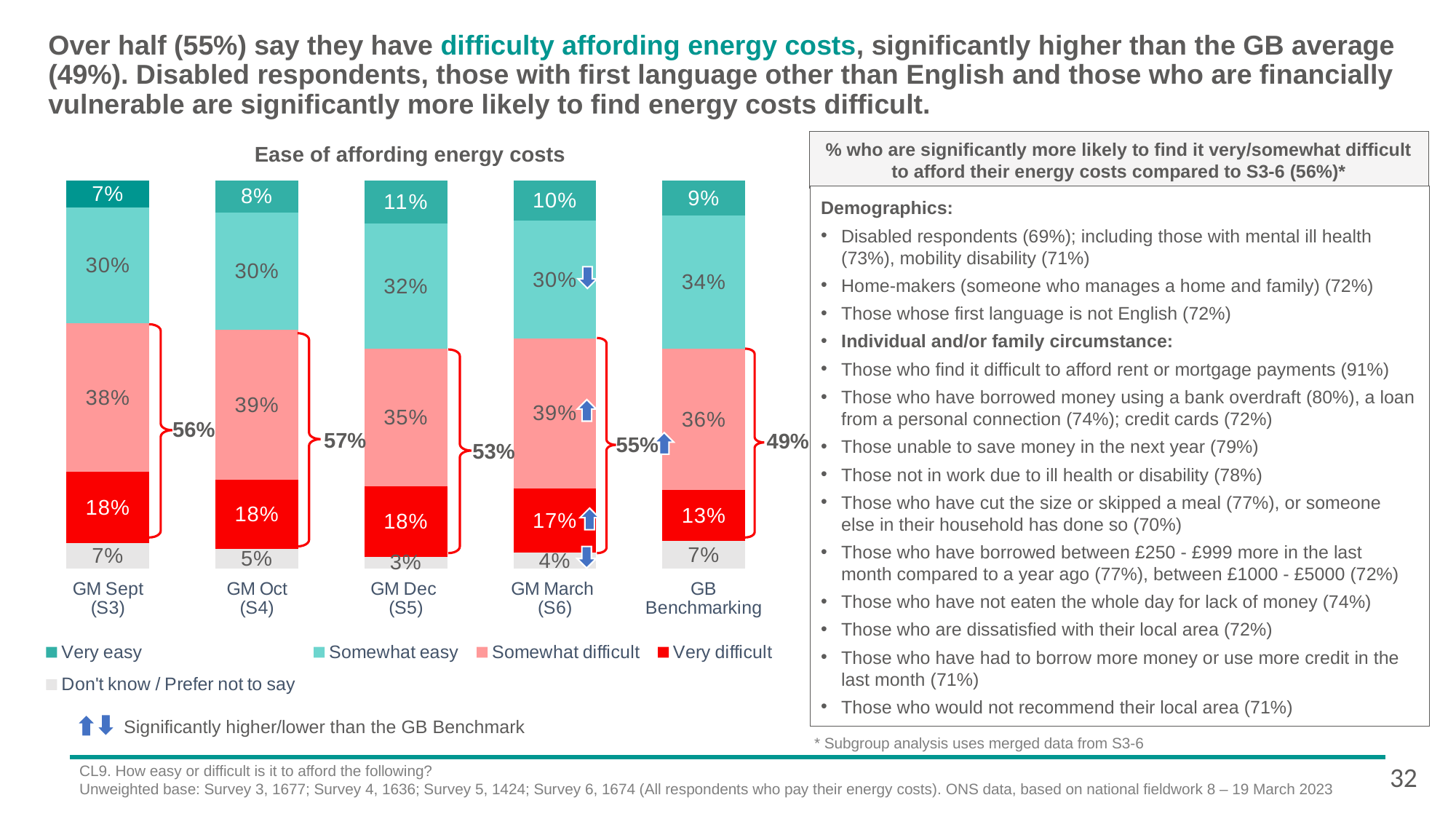
What is the 'Don't know / Prefer not to say' value for GM Oct (S4)? 5% How many series does the legend list? 5 Which category has the lowest 'Very difficult' value? GB Benchmarking What is the 'Very easy' value for GM Dec (S5)? 11% Which is larger: the 'Very difficult' value for GM Sept (S3) or for GB Benchmarking? GM Sept (S3) Which category has the highest 'Very easy' value? GM Dec (S5) What type of chart is 'Ease of affording energy costs'? Stacked bar chart What is the 'Somewhat easy' value for GB Benchmarking? 34% What is the combined 'Somewhat difficult' plus 'Very difficult' share shown for GM Oct (S4)? 57% What is the difference between the 'Somewhat difficult' values for GM Oct (S4) and GM Dec (S5)? 4% How many categories (bars) are shown in the chart? 5 What percentage of GM March (S6) respondents said it was very difficult to afford energy costs? 17%